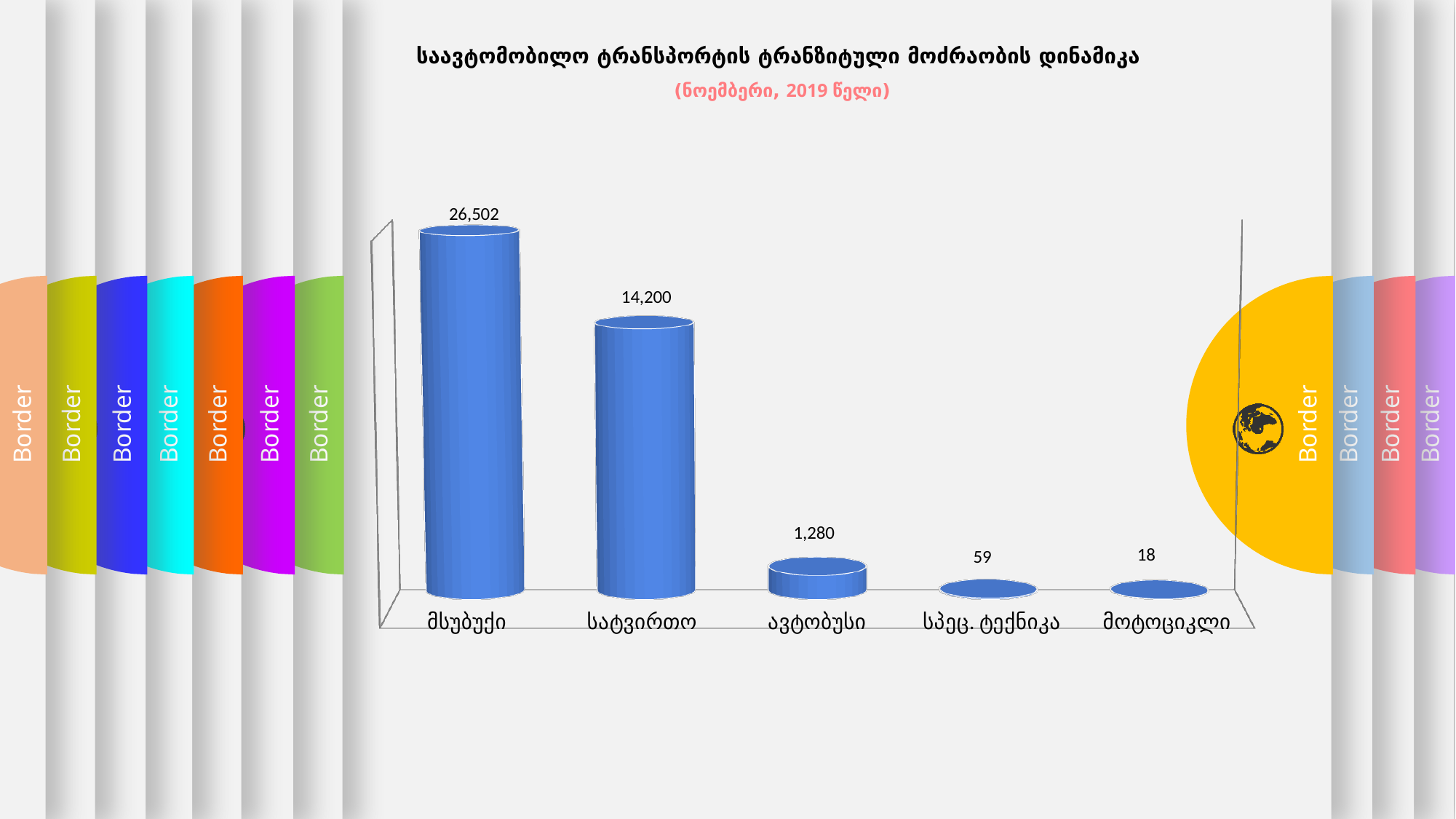
Which category has the highest value? მსუბუქი What is the value for ავტობუსი? 1,280 What is the value for მოტოციკლი? 18 What kind of chart is shown on the slide? Bar chart Which category has the lowest value? მოტოციკლი What is the value for სპეც. ტექნიკა? 59 What is the value for მსუბუქი? 26,502 How many categories are shown on the chart? 5 What is the value for სატვირთო? 14,200 What period is given in the chart's subtitle? ნოემბერი, 2019 წელი Which is larger, the value for ავტობუსი or the value for სპეც. ტექნიკა? ავტობუსი What is the difference between the values for მსუბუქი and სატვირთო? 12,302